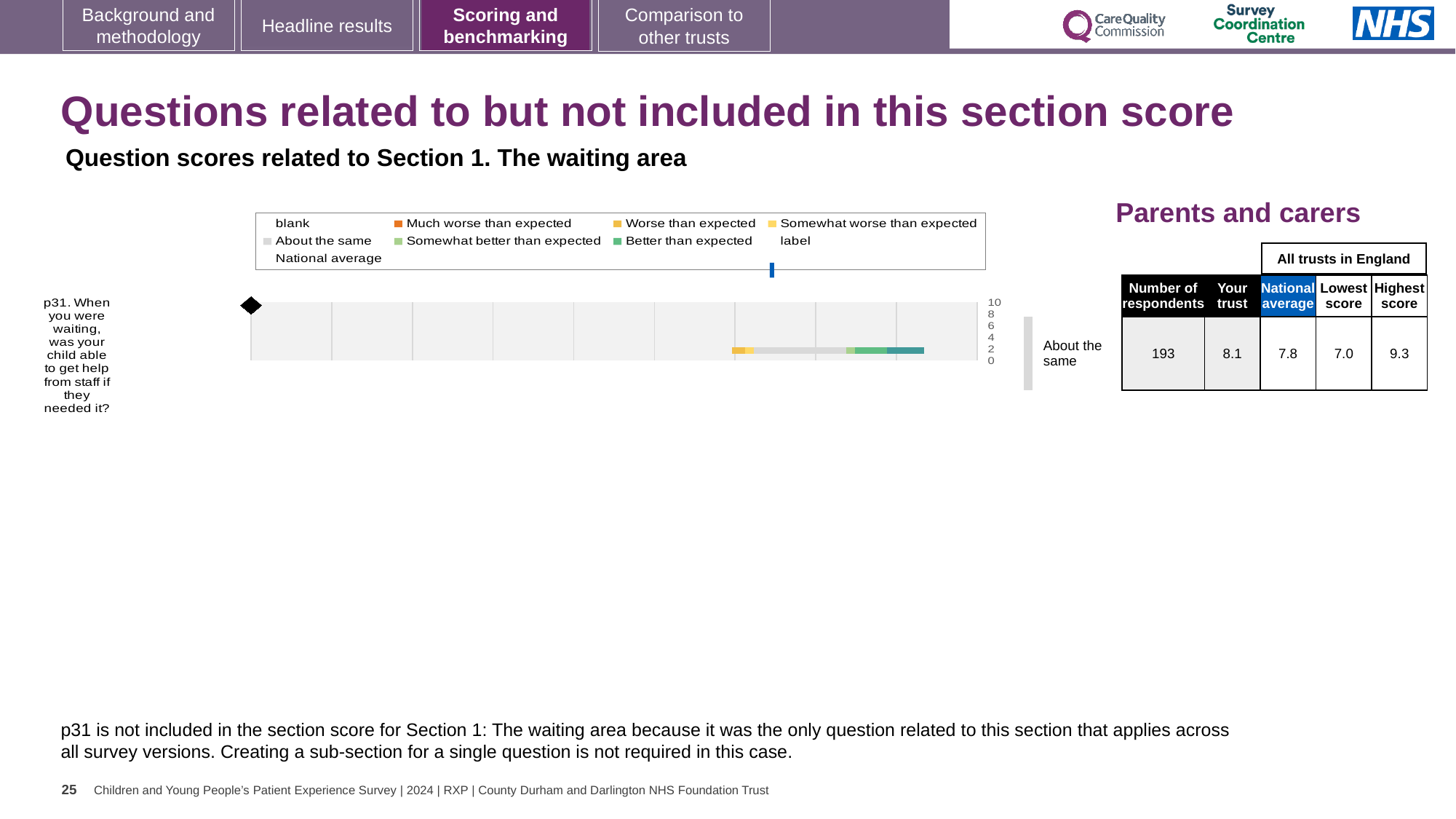
What is the lowest score among all trusts in England for question p31? 7.0 What is the highest value shown on the chart's axis? 10 Which is larger for question p31: the 'Your trust' score or the national average? Your trust What is the highest score among all trusts in England for question p31? 9.3 What is the difference between the 'Your trust' score and the national average for question p31? 0.3 How many survey questions are plotted in the chart? 1 What is the national average score for question p31? 7.8 How many respondents answered question p31? 193 What is the 'Your trust' score for question p31? 8.1 What kind of chart is used to show the result for question p31? bar chart What is the difference between the highest score and the lowest score for question p31? 2.3 Which legend entry is shown with an orange marker? Much worse than expected